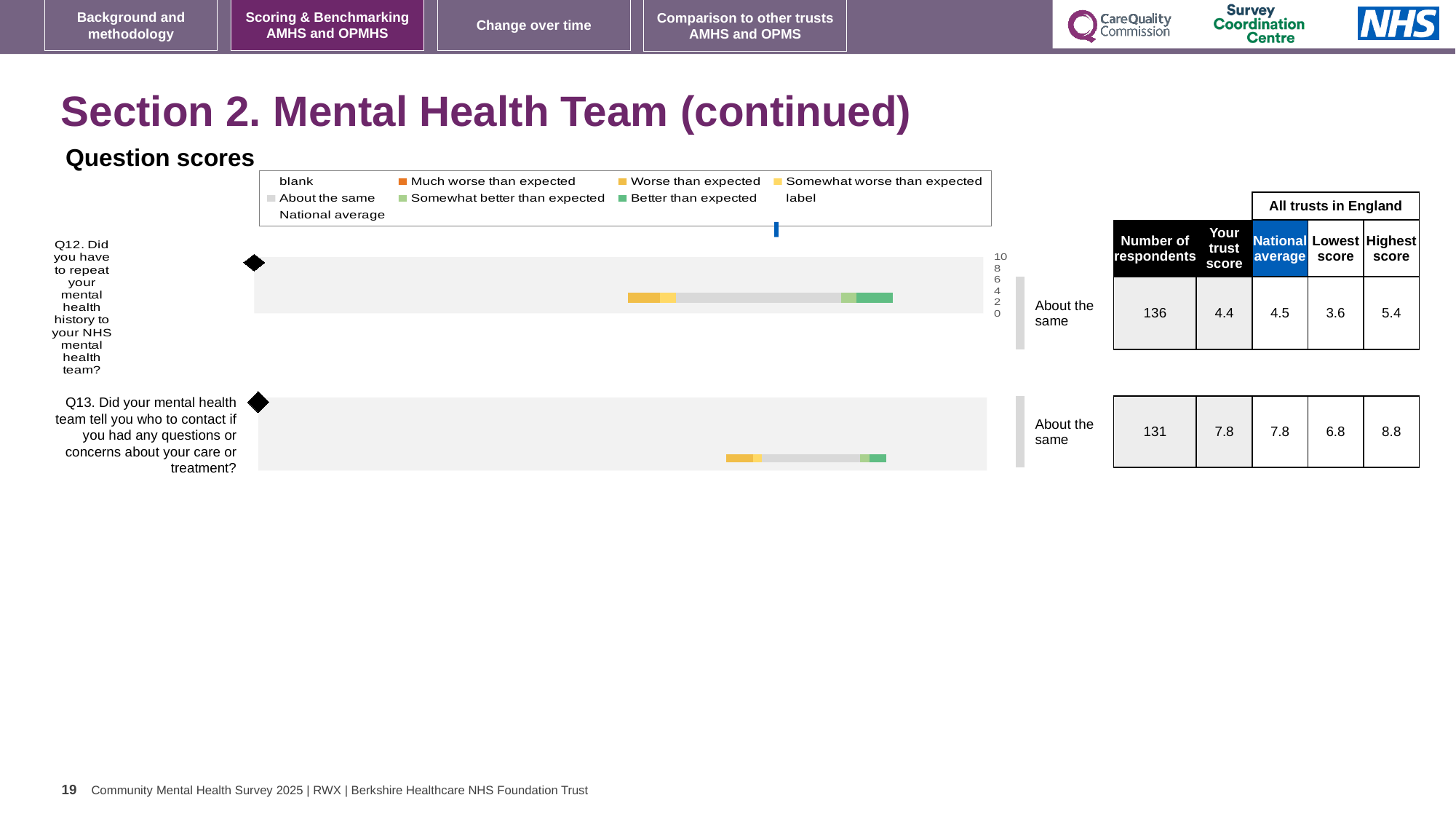
What kind of chart is used to show the question scores for Q12 and Q13? bar chart What benchmark category is shown beside the bar for Q13? About the same What is the number of respondents for Q12 in the table next to the chart? 136 What is the trust's score for Q12 (repeating mental health history)? 4.4 How many questions are plotted in the question scores chart? 2 Which is larger for Q12: the trust's score or the national average? national average What is the national average score for Q12? 4.5 What is the difference between the highest and lowest scores for Q12? 1.8 What is the number of respondents for Q13? 131 What is the difference between the highest and lowest scores for Q13? 2.0 What is the highest score among all trusts in England for Q13? 8.8 What is the lowest score among all trusts in England for Q12? 3.6